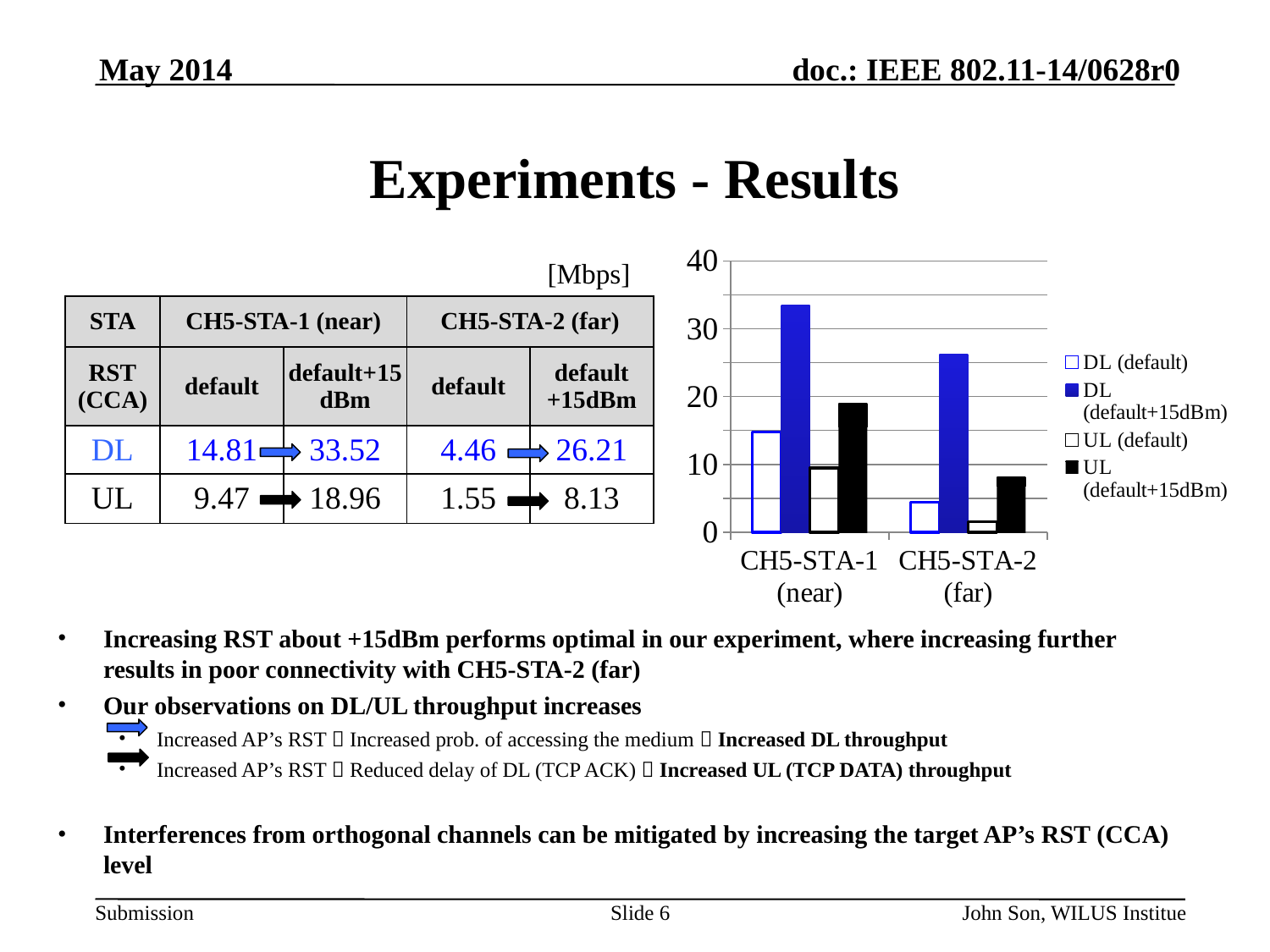
How many categories are shown on the x axis of the chart? 2 Is the UL (default+15dBm) value for CH5-STA-2 (far) greater or less than 10? less Which series has the shortest bar for CH5-STA-2 (far)? UL (default) What unit is given for the values in the chart and table? Mbps Which is larger: DL (default+15dBm) for CH5-STA-1 (near) or DL (default+15dBm) for CH5-STA-2 (far)? CH5-STA-1 (near) What kind of chart is shown on the slide? bar chart Which series has the tallest bar for CH5-STA-1 (near)? DL (default+15dBm) What is the difference between the DL (default+15dBm) and DL (default) values for CH5-STA-1 (near)? 18.71 How many series does the chart legend list? 4 According to the slide, what is the DL throughput for CH5-STA-2 (far) with default+15dBm RST? 26.21 Is the DL (default+15dBm) value for CH5-STA-1 (near) greater or less than 30? greater According to the slide, what is the UL throughput for CH5-STA-1 (near) with default RST? 9.47